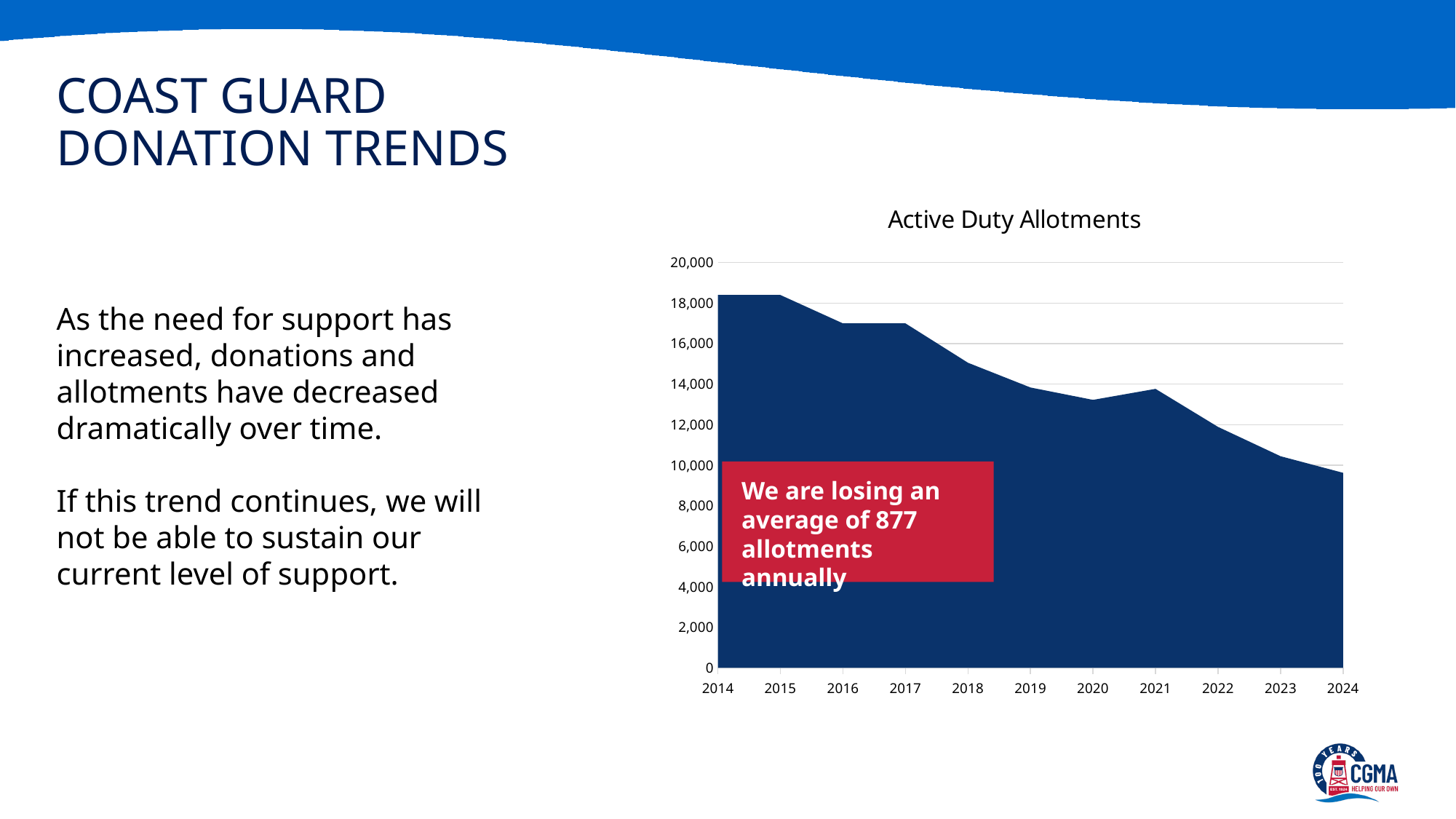
Is the value for 2020 greater or less than 14,000? less Is the value for 2018 greater or less than 14,000? greater Which year has the larger value, 2014 or 2024? 2014 Is the value for 2024 greater or less than 10,000? less Do the Active Duty Allotments values generally rise or fall from 2014 to 2024? fall According to the annotation on the chart, how many allotments are being lost on average annually? 877 How many years are plotted along the x axis of the chart? 11 Which year has the lowest value for Active Duty Allotments? 2024 What kind of chart is shown on the slide? area chart What is the title of the chart? Active Duty Allotments